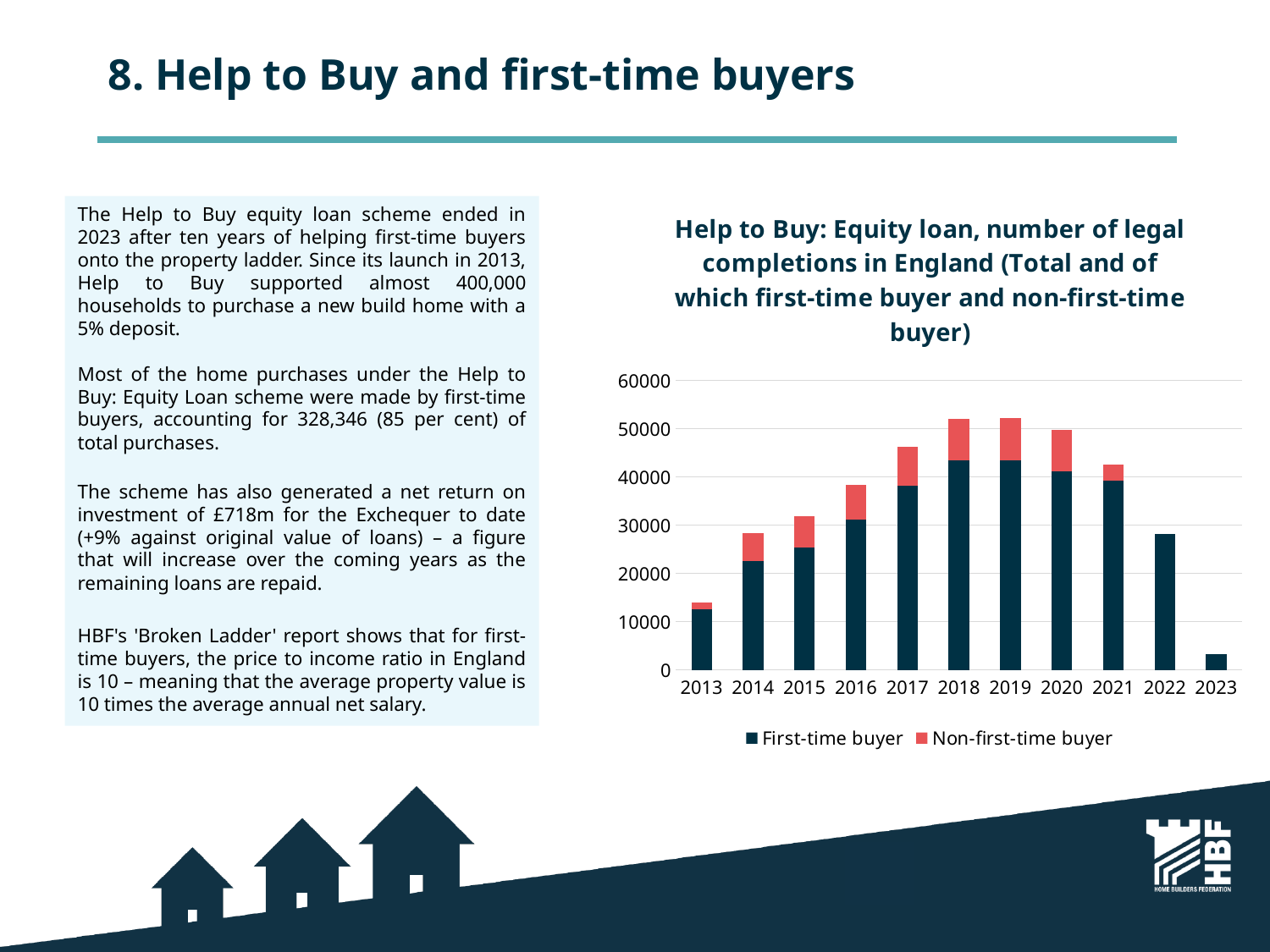
Which year has the lowest total number of legal completions in the chart? 2023 Is the total value for 2013 greater or less than 10000? greater What kind of chart is shown on the slide? Stacked bar chart Which series is shown in red in the chart? Non-first-time buyer Is the total value for 2023 greater or less than 10000? less Do the total values rise or fall from 2013 to 2018? rise How many series does the chart's legend list? 2 Is the total value for 2018 greater or less than 50000? greater Do the total values rise or fall from 2019 to 2023? fall How many years are shown on the x axis of the chart? 11 Which year has the larger total, 2014 or 2017? 2017